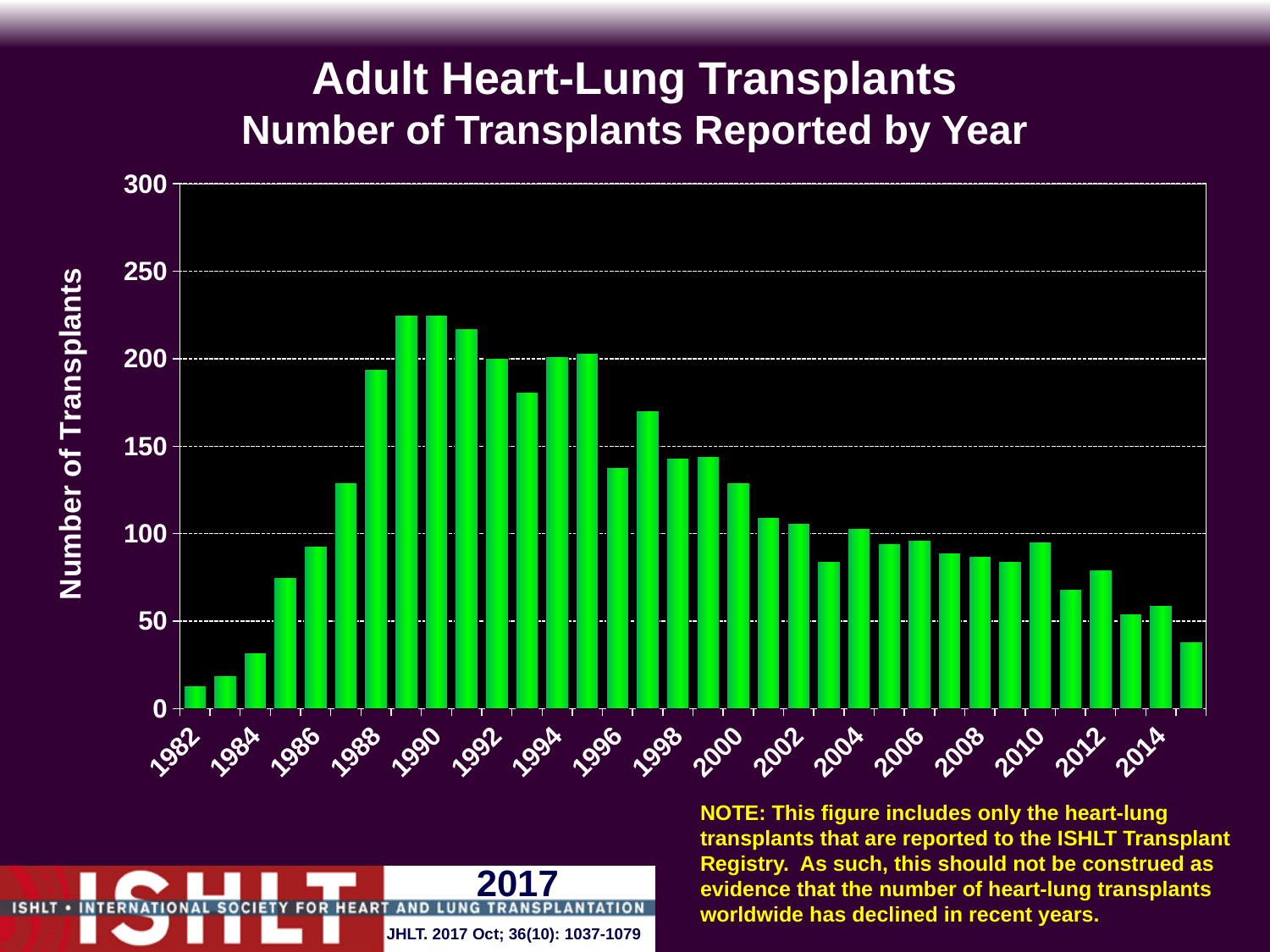
Is the value for 1988 greater or less than 150? greater Which year has the lowest number of transplants? 1982 What kind of chart is shown on the slide? bar chart Is the value for 2008 greater or less than 100? less Do the values generally rise or fall from 1990 to 2015? fall Which year has the larger value, 1988 or 1996? 1988 Is the value for 1984 greater or less than 50? less What is the label on the vertical axis? Number of Transplants Which year has the larger value, 2002 or 2012? 2002